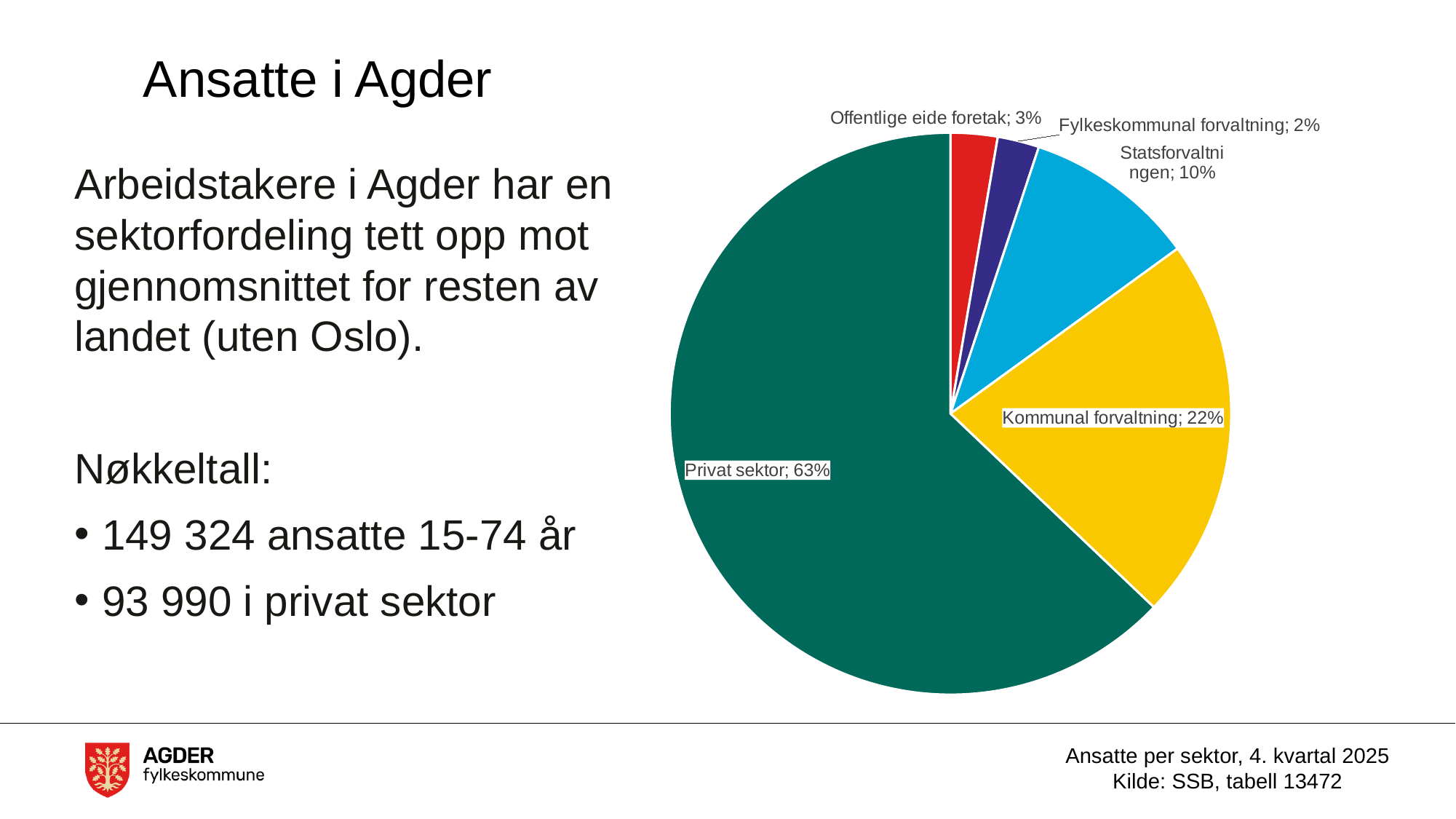
Which is larger, Statsforvaltningen or Kommunal forvaltning? Kommunal forvaltning Which sector has the largest slice of the pie? Privat sektor How many slices does the pie chart have? 5 What colour is the Privat sektor slice? Dark green What is the difference in percentage points between Privat sektor and Kommunal forvaltning? 41 percentage points What is the value shown for Kommunal forvaltning? 22% What share of the pie does Privat sektor have? 63% What is the value shown for Fylkeskommunal forvaltning? 2% What kind of chart is shown on the slide? Pie chart What is the value shown for Offentlige eide foretak? 3% Which sector has the smallest slice of the pie? Fylkeskommunal forvaltning What is the value shown for Statsforvaltningen? 10%